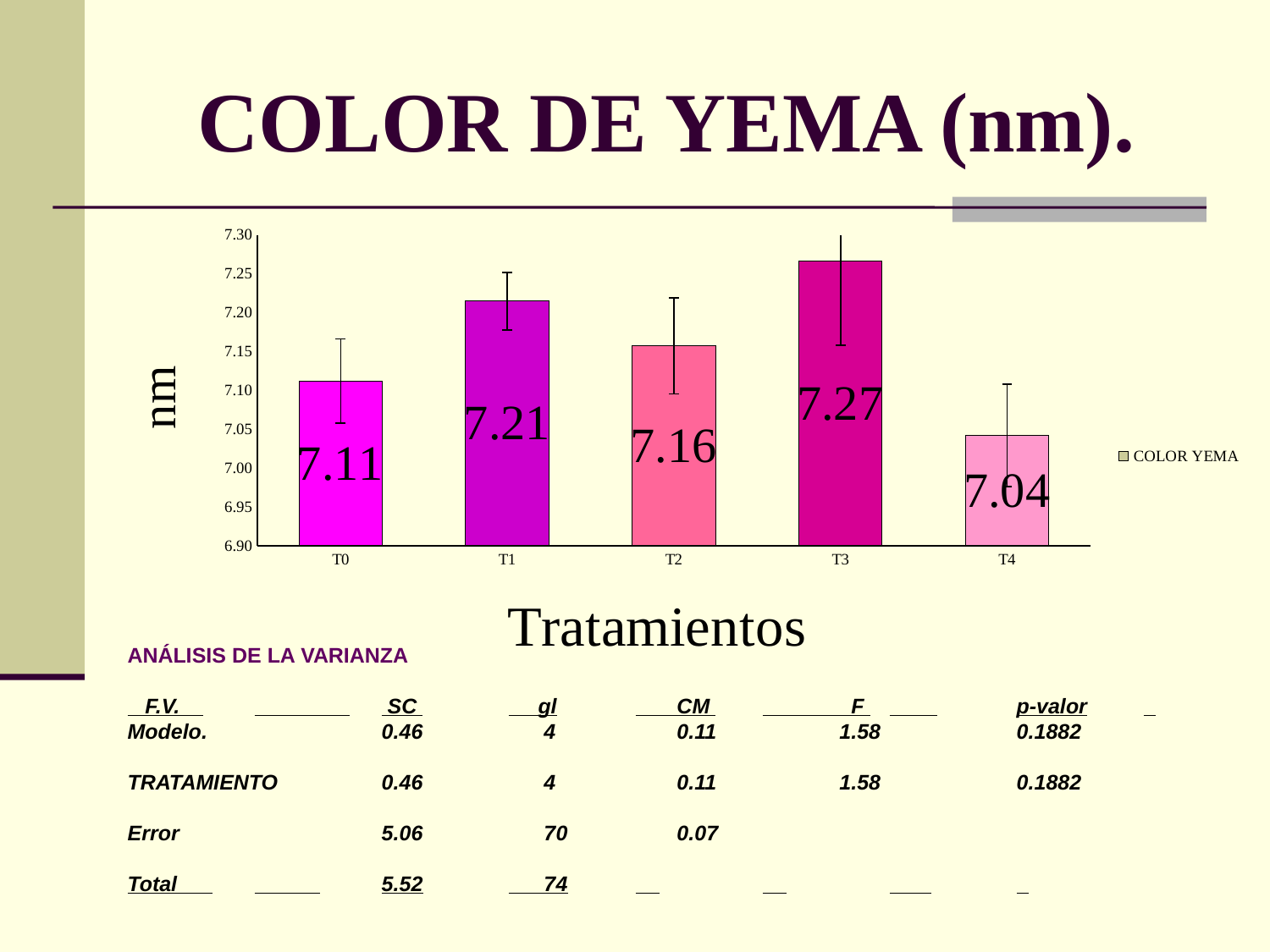
Which is larger, the value for T1 or the value for T2? T1 What is the only entry in the chart legend? COLOR YEMA Which treatment has the lowest value? T4 How many treatments are shown on the x axis? 5 Which treatment has the highest value? T3 What is the value for T0? 7.11 Is the value for T2 greater or less than 7.10? greater What is the difference between the values for T1 and T2? 0.05 What is the value for T4? 7.04 What is the value for T3? 7.27 What is the difference between the values for T3 and T4? 0.23 What kind of chart is shown on the slide? bar chart